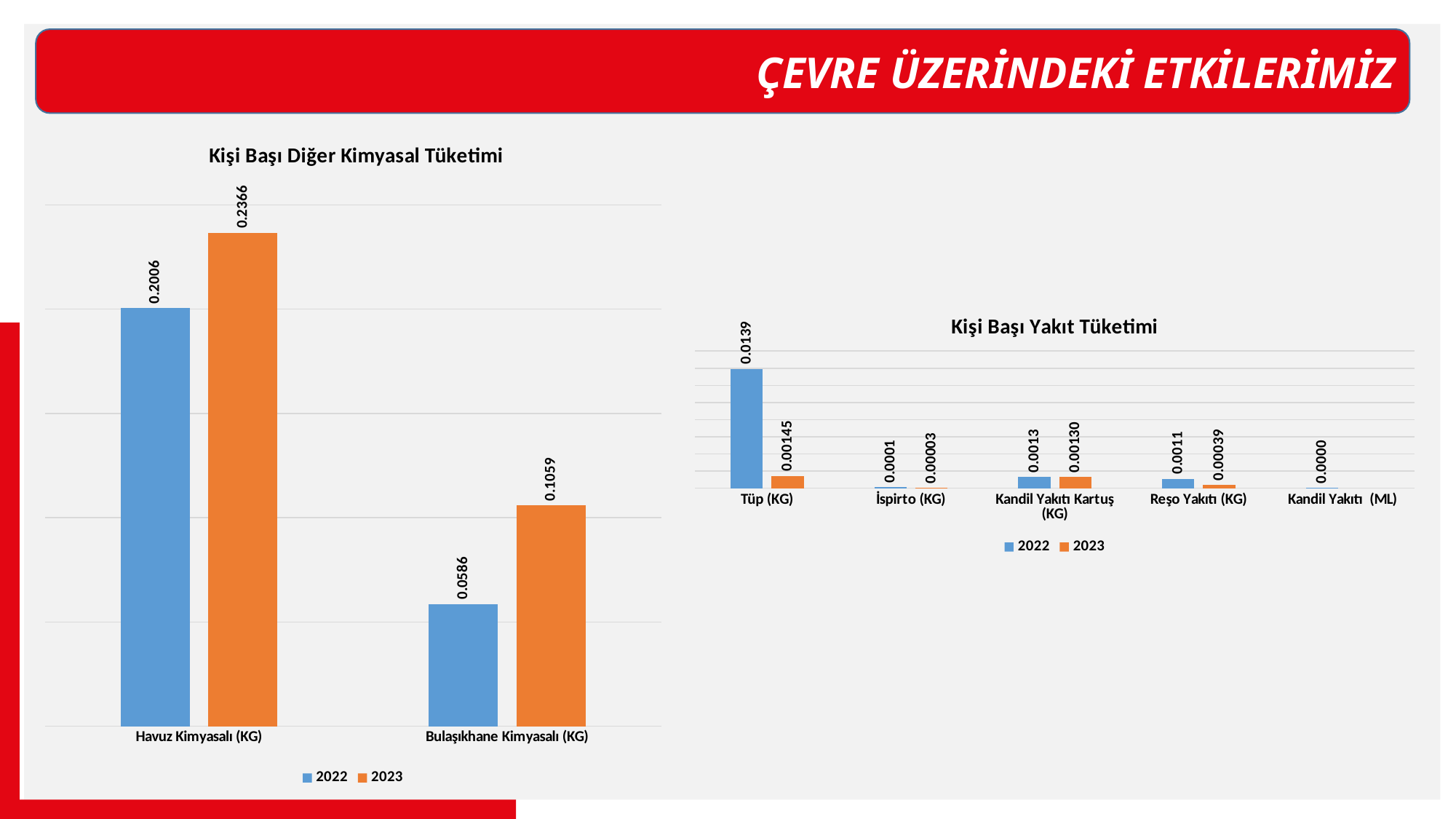
In the chart titled 'Kişi Başı Diğer Kimyasal Tüketimi', what is the 2023 value for Havuz Kimyasalı (KG)? 0.2366 In the chart titled 'Kişi Başı Yakıt Tüketimi', how many categories are shown on the x axis? 5 In the chart titled 'Kişi Başı Diğer Kimyasal Tüketimi', which category has the highest 2023 value? Havuz Kimyasalı (KG) In the chart titled 'Kişi Başı Yakıt Tüketimi', which is larger for Tüp (KG): the 2022 value or the 2023 value? 2022 In the chart titled 'Kişi Başı Yakıt Tüketimi', what is the 2023 value for Reşo Yakıtı (KG)? 0.00039 In the chart titled 'Kişi Başı Diğer Kimyasal Tüketimi', what is the difference between the 2023 and 2022 values for Havuz Kimyasalı (KG)? 0.0360 In the chart titled 'Kişi Başı Diğer Kimyasal Tüketimi', how many series does the legend list? 2 In the chart titled 'Kişi Başı Yakıt Tüketimi', what is the 2023 value for Kandil Yakıtı Kartuş (KG)? 0.00130 In the chart titled 'Kişi Başı Yakıt Tüketimi', which category has the highest 2022 value? Tüp (KG) In the chart titled 'Kişi Başı Diğer Kimyasal Tüketimi', what is the 2022 value for Bulaşıkhane Kimyasalı (KG)? 0.0586 What kind of chart is the one titled 'Kişi Başı Yakıt Tüketimi'? Bar chart In the chart titled 'Kişi Başı Yakıt Tüketimi', what is the 2022 value for Tüp (KG)? 0.0139